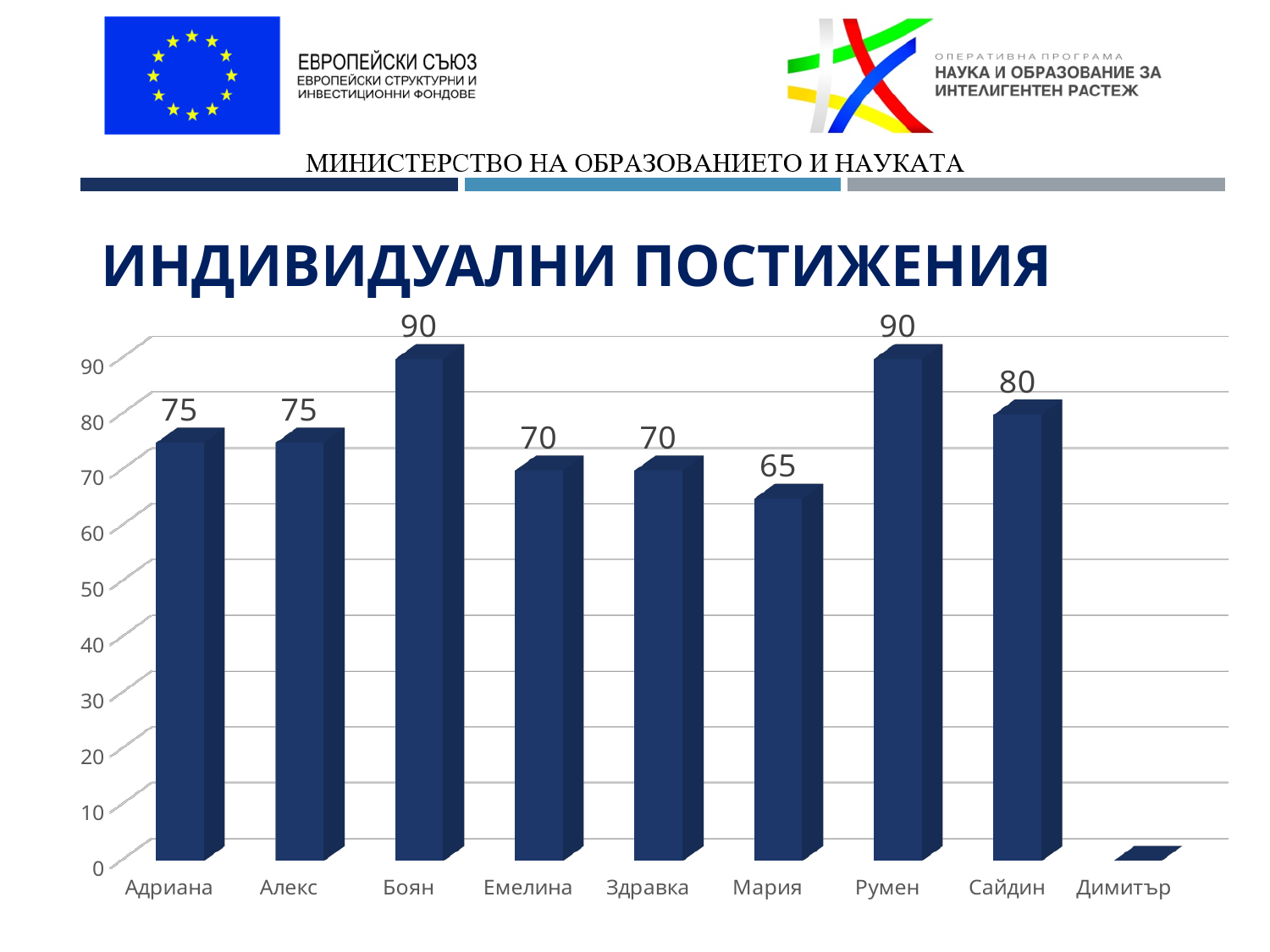
How many categories are shown on the x axis? 9 What kind of chart is shown on the slide? bar chart What is the difference between the values for Боян and Мария? 25 What is the title of the chart? ИНДИВИДУАЛНИ ПОСТИЖЕНИЯ Which is larger, the value for Сайдин or the value for Адриана? Сайдин What is the value for Мария? 65 What is the highest value shown in the chart? 90 What is the value for Боян? 90 What is the value for Сайдин? 80 Is the value for Димитър greater or less than 10? less Which category has the lowest value? Димитър What is the value for Здравка? 70